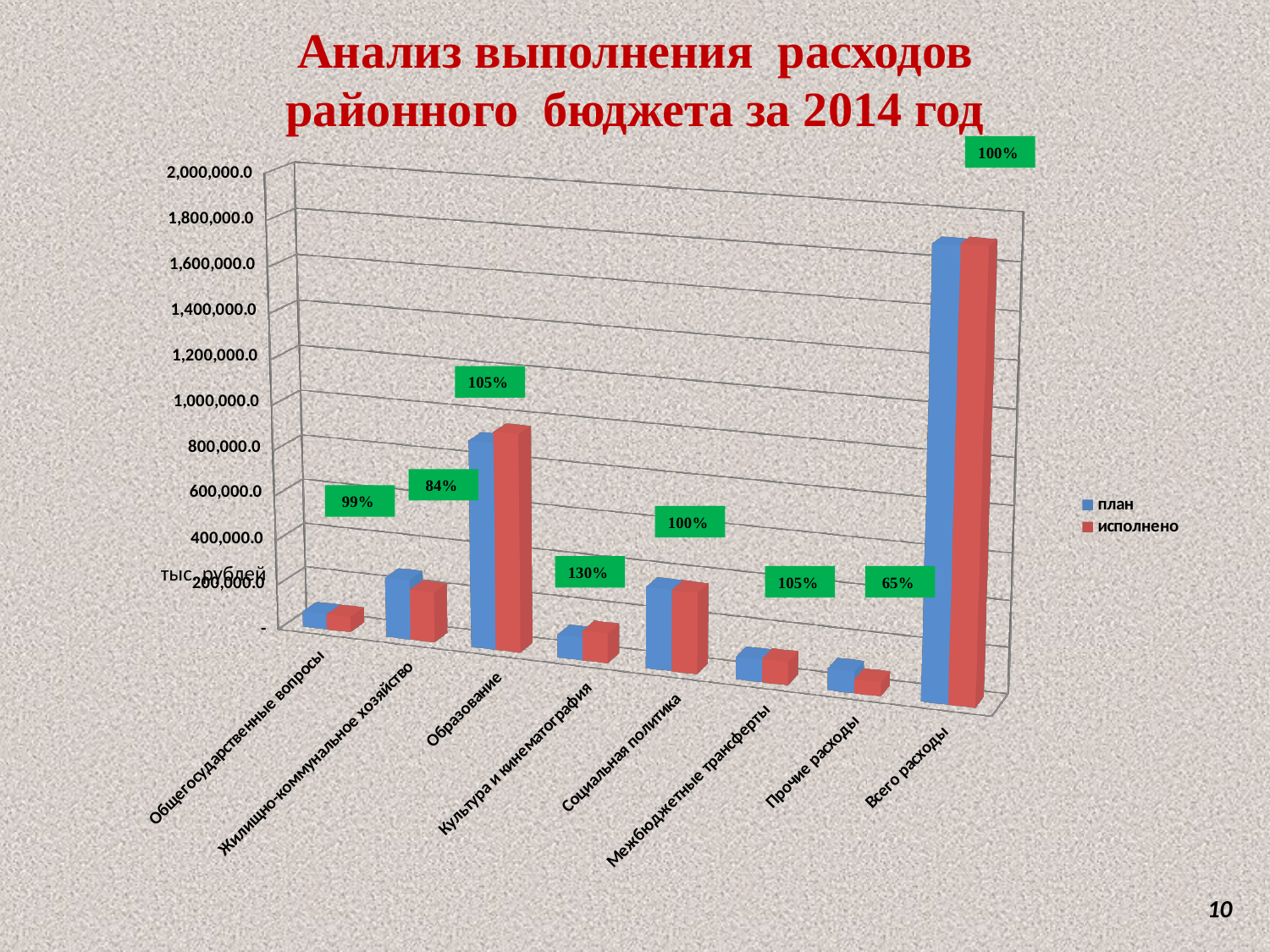
What percentage label is shown above the bars for Культура и кинематография? 130% What percentage label is shown above the bars for Прочие расходы? 65% How many categories are shown on the x axis? 8 Which category has the highest bars? Всего расходы Is the план value for Всего расходы greater or less than 1,400,000.0? greater How many series does the legend list? 2 What kind of chart is shown on the slide? bar chart What percentage label is shown above the bars for Образование? 105% Is the план value for Образование greater or less than 600,000.0? greater What are the two series named in the legend? план, исполнено Which has the larger план value, Образование or Социальная политика? Образование What percentage label is shown above the bars for Жилищно-коммунальное хозяйство? 84%